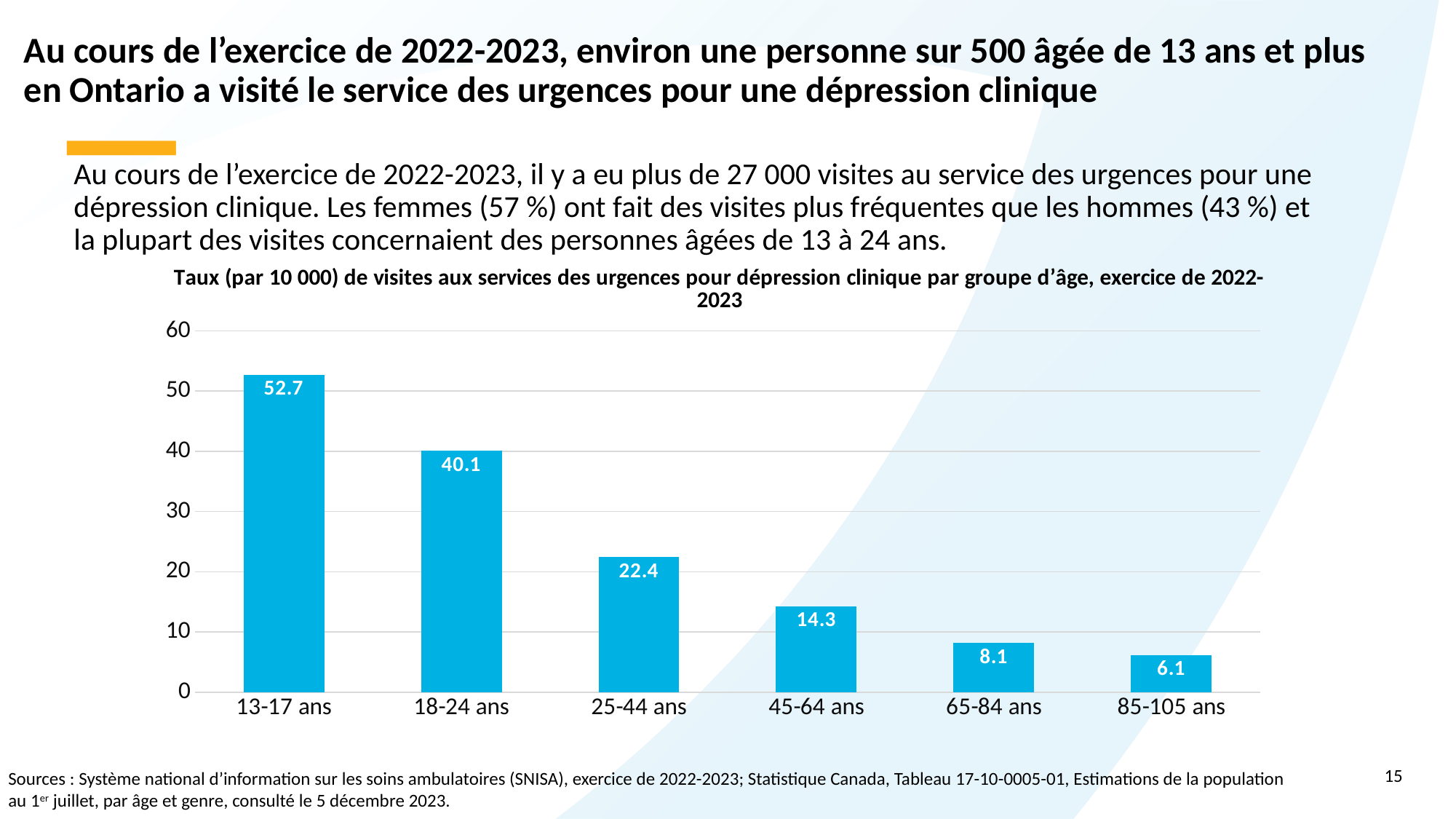
Is the value for the 18-24 ans age group greater or less than 30? greater Which age group has the highest rate of emergency department visits for clinical depression? 13-17 ans Which age group has the lowest rate of emergency department visits for clinical depression? 85-105 ans What is the value shown for the 45-64 ans age group? 14.3 Which age group has a higher rate: 25-44 ans or 45-64 ans? 25-44 ans What is the difference between the rates for the 25-44 ans and 65-84 ans age groups? 14.3 What is the rate (per 10 000) of emergency department visits for clinical depression for the 13-17 ans age group? 52.7 What is the value shown for the 85-105 ans age group? 6.1 What is the difference between the rates for the 13-17 ans and 18-24 ans age groups? 12.6 What kind of chart is shown on the slide? Bar chart Do the values rise or fall as the age groups move from youngest to oldest along the x axis? Fall How many age groups are shown on the chart? 6